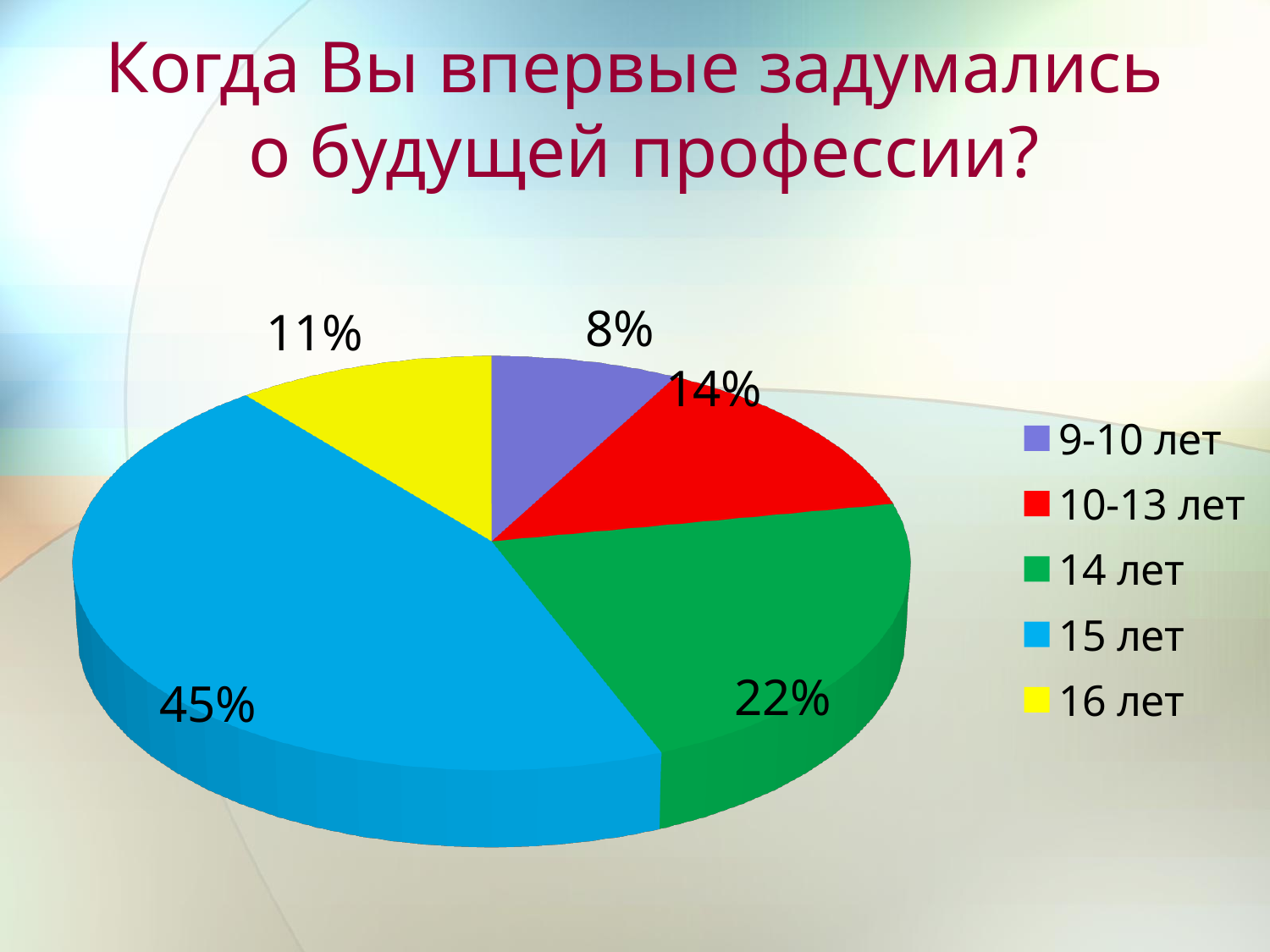
What share of the pie does the "15 лет" slice represent? 45% What colour is the slice for "14 лет"? Green What is the value shown for "10-13 лет"? 14% Which category has the largest slice of the pie? 15 лет What kind of chart is shown on the slide? Pie chart What is the value shown for "14 лет"? 22% What is the difference between the values for "15 лет" and "14 лет"? 23% What is the value shown for "16 лет"? 11% What is the value shown for "9-10 лет"? 8% Which is larger, the value for "10-13 лет" or the value for "16 лет"? 10-13 лет Which category has the smallest slice of the pie? 9-10 лет How many categories does the pie chart show? 5